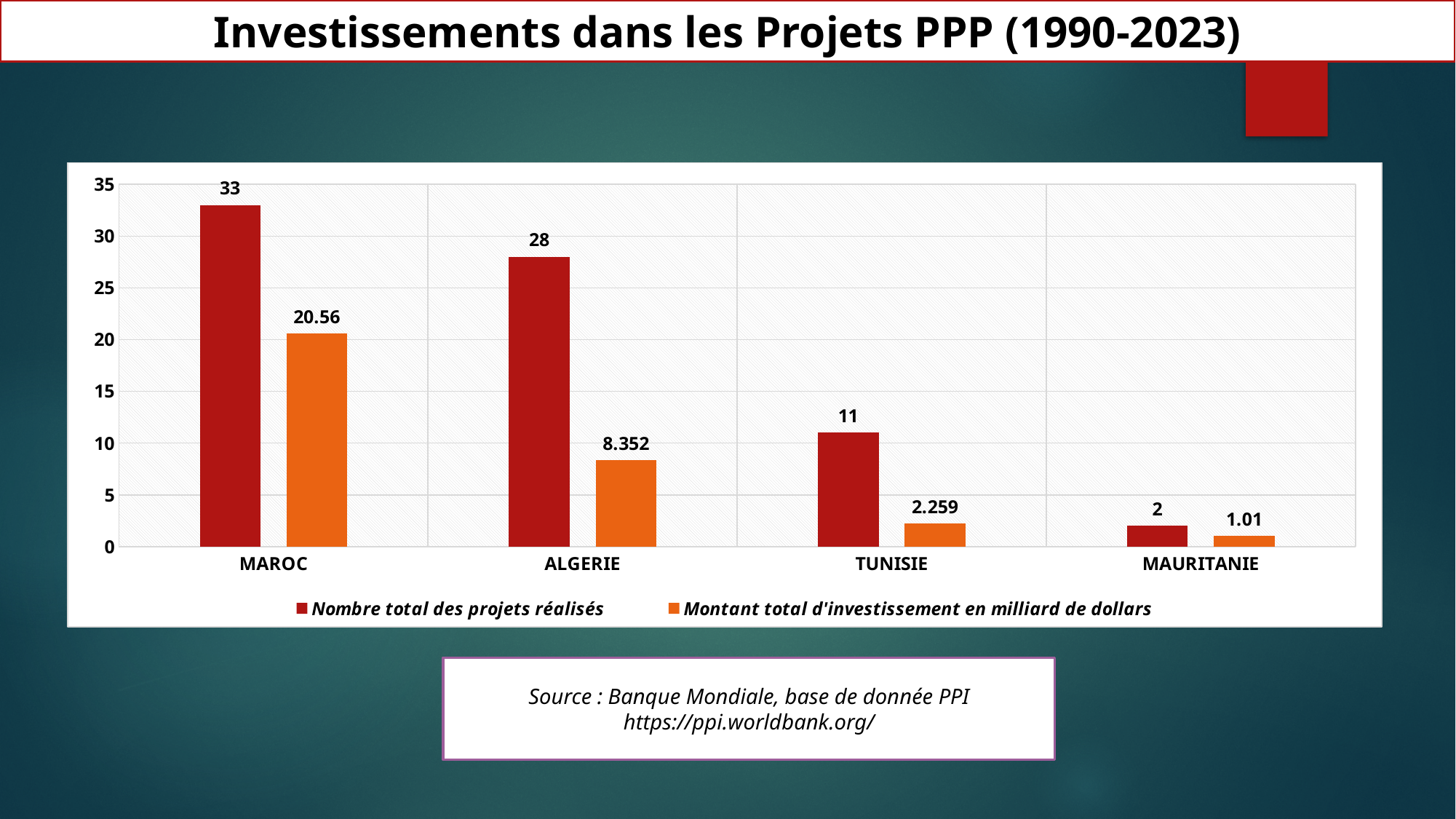
How many countries are shown on the x axis? 4 What is the value of 'Nombre total des projets réalisés' for MAROC? 33 What is the difference in 'Nombre total des projets réalisés' between MAROC and ALGERIE? 5 Do the values of 'Nombre total des projets réalisés' rise or fall from MAROC to MAURITANIE? Fall Which country has the highest 'Nombre total des projets réalisés'? MAROC Which is larger: the 'Montant total d'investissement en milliard de dollars' for MAROC or for ALGERIE? MAROC What is the value of 'Nombre total des projets réalisés' for MAURITANIE? 2 Which country has the lowest 'Montant total d'investissement en milliard de dollars'? MAURITANIE What is the value of 'Montant total d'investissement en milliard de dollars' for ALGERIE? 8.352 What kind of chart is shown on the slide? Bar chart How many series does the legend list? 2 What is the value of 'Montant total d'investissement en milliard de dollars' for TUNISIE? 2.259